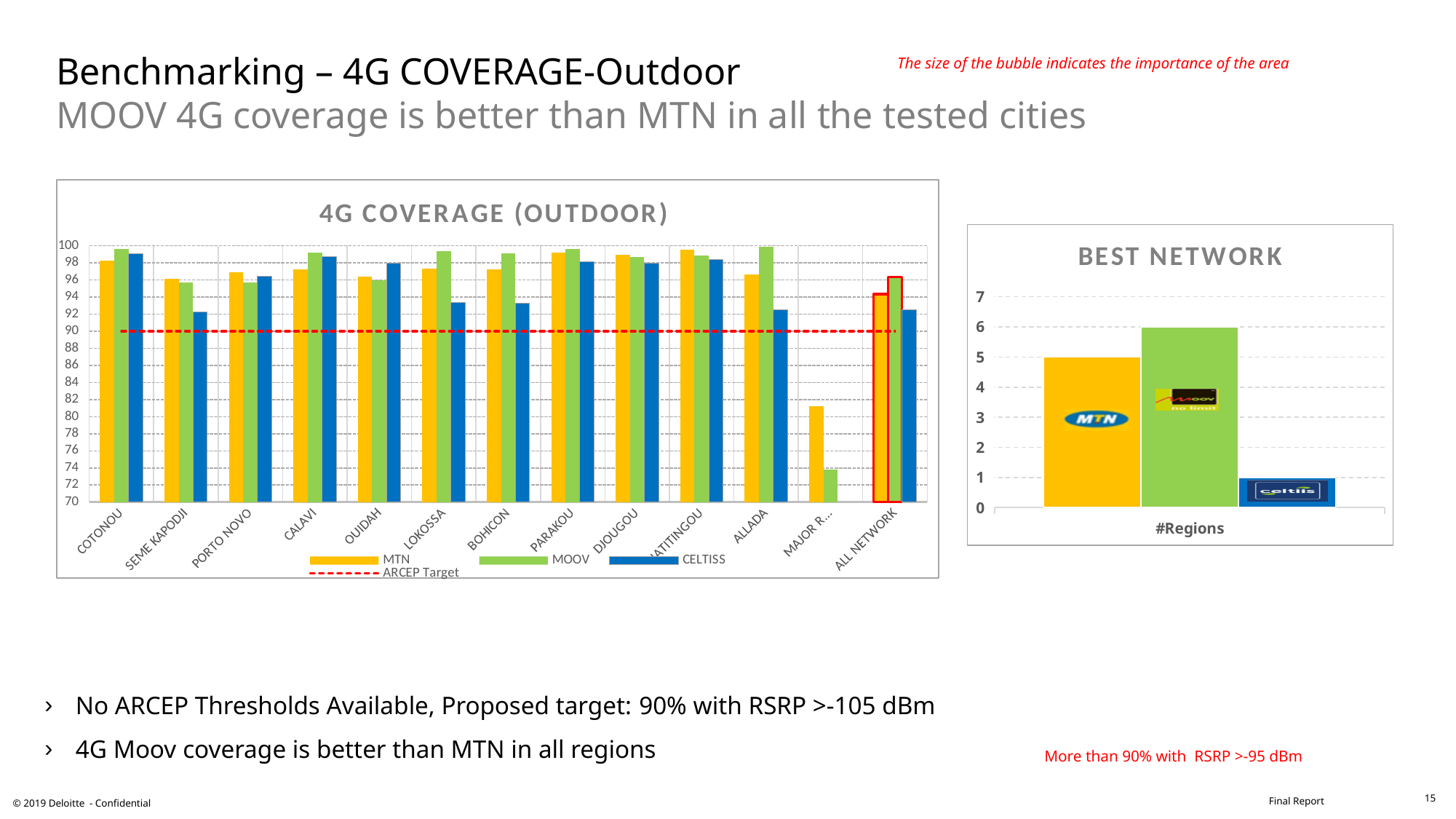
In the BEST NETWORK chart, which network has the highest number of regions? MOOV In the 4G COVERAGE (OUTDOOR) chart, how many series does the legend list? 4 In the 4G COVERAGE (OUTDOOR) chart, which is larger at ALLADA, the MOOV value or the CELTISS value? MOOV In the BEST NETWORK chart, what is the difference between the MOOV and MTN values? 1 In the 4G COVERAGE (OUTDOOR) chart, is the MOOV value for MAJOR R... greater or less than 80? less In the 4G COVERAGE (OUTDOOR) chart, is the CELTISS value for SEME KAPODJI greater or less than 90? greater What kind of chart is the 4G COVERAGE (OUTDOOR) chart? Combination bar and line chart (bars with a dashed ARCEP Target line) In the 4G COVERAGE (OUTDOOR) chart, how many categories are shown on the x axis? 13 In the BEST NETWORK chart, what is the value for Celtiis? 1 In the BEST NETWORK chart, what is the value for MOOV? 6 In the BEST NETWORK chart, which network has the lowest number of regions? Celtiis In the BEST NETWORK chart, what is the value for MTN? 5